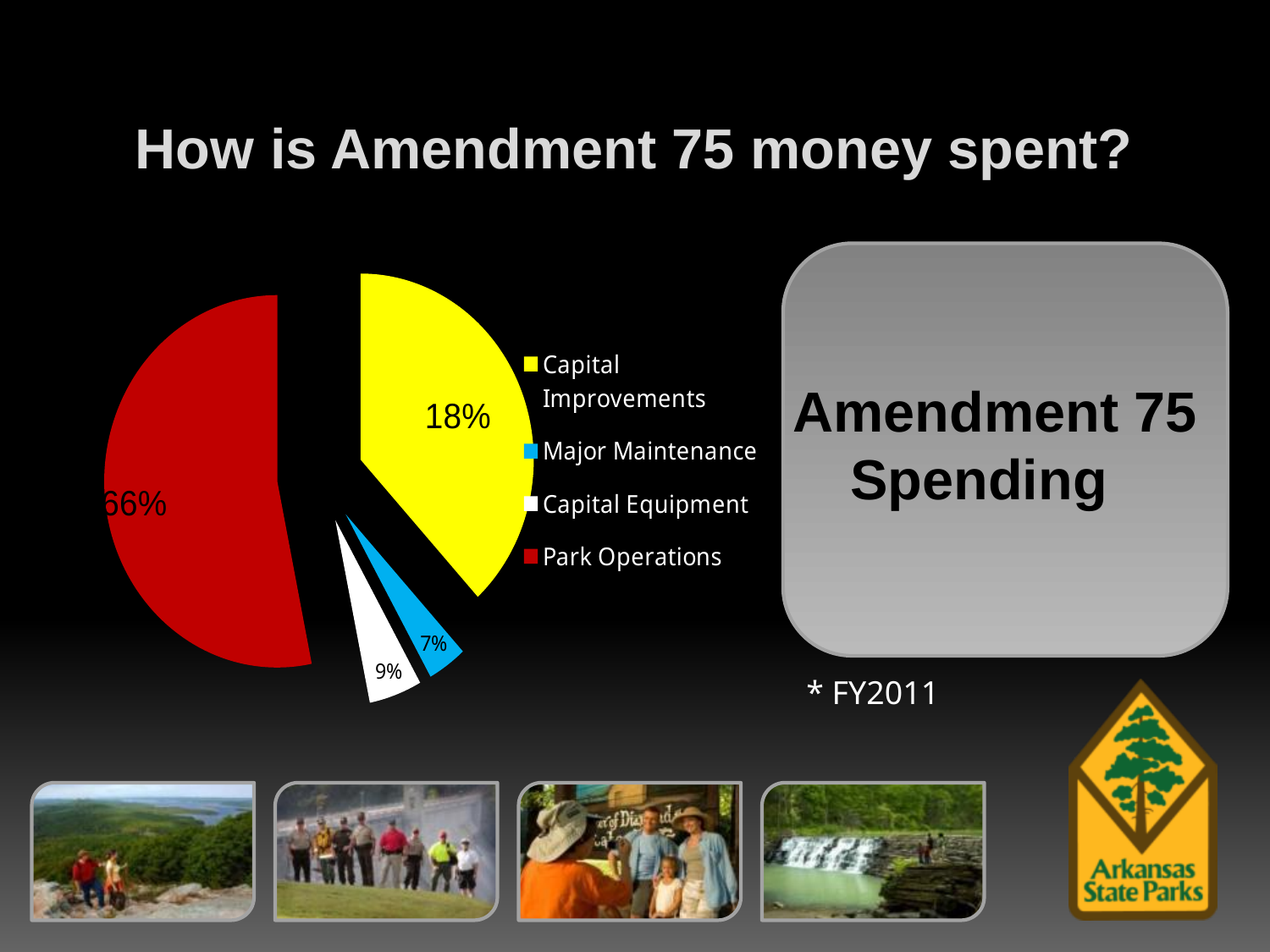
How many categories does the pie chart show? 4 What share of Amendment 75 spending goes to Capital Equipment? 9% What share of Amendment 75 spending goes to Park Operations? 66% Which category receives the largest share of Amendment 75 spending? Park Operations What colour is the Park Operations slice of the pie chart? red What share of Amendment 75 spending goes to Capital Improvements? 18% Which category receives the smallest share of Amendment 75 spending? Major Maintenance What share of Amendment 75 spending goes to Major Maintenance? 7% What kind of chart is shown on the slide? pie chart How many percentage points larger is the Park Operations share than the Capital Improvements share? 48 Which is larger, the share for Capital Equipment or the share for Major Maintenance? Capital Equipment Which fiscal year does the chart's footnote refer to? FY2011